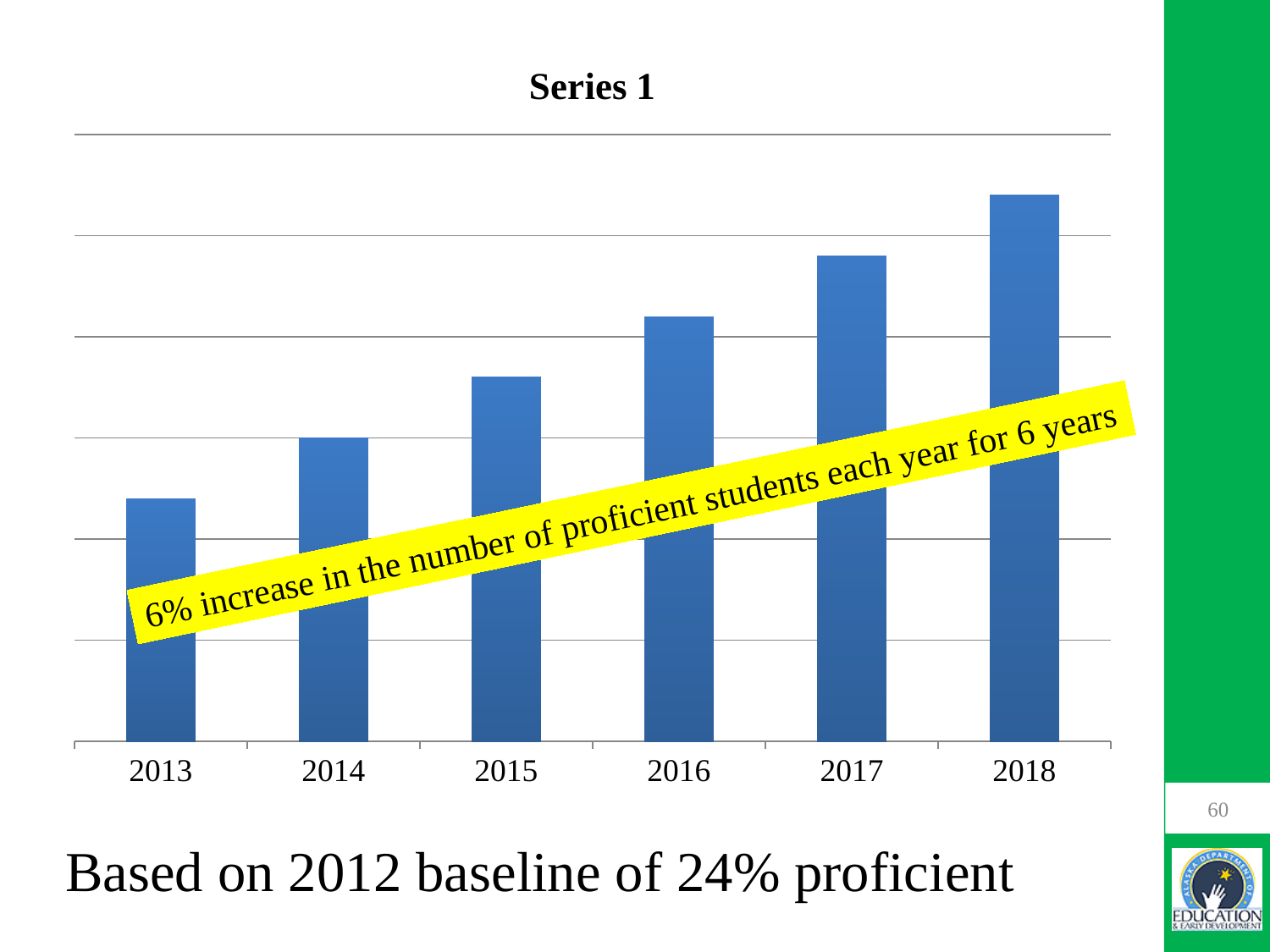
Which year has the larger value, 2015 or 2017? 2017 How many years are shown along the x axis of the chart? 6 Which year has the lowest bar in the chart? 2013 What kind of chart is shown on the slide? bar chart What is the first year shown on the x axis of the chart? 2013 What is the title of the chart? Series 1 Do the bar values rise or fall from 2013 to 2018? rise Which year has the highest bar in the chart? 2018 Which year has the larger value, 2014 or 2013? 2014